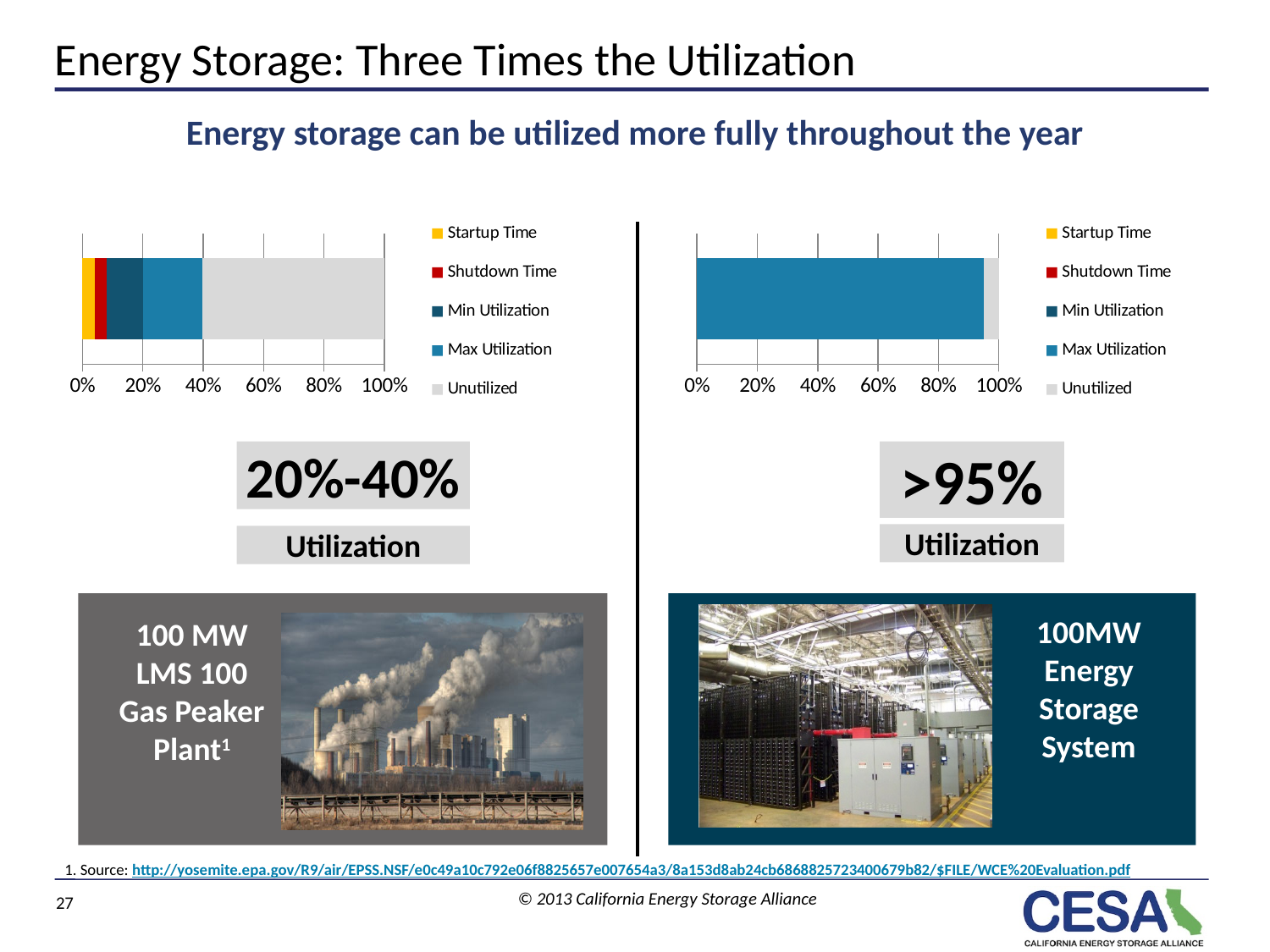
In the right chart, which series occupies the largest portion of the bar? Max Utilization In the left chart's legend, what colour represents Unutilized? Light grey How many series does the legend of the left chart list? 5 What is the highest value shown on the x axis of the right chart? 100% In the left chart, is the Unutilized segment greater or less than 40%? greater What kind of chart is the left chart on the slide? Stacked bar chart In the right chart, is the Unutilized segment greater or less than 20%? less In the left chart, which series occupies the largest portion of the bar? Unutilized How many series does the legend of the right chart list? 5 In the right chart, is the Max Utilization segment greater or less than 80%? greater In the left chart, which is larger: the Unutilized segment or the Max Utilization segment? Unutilized In the left chart, which is larger: the Max Utilization segment or the Startup Time segment? Max Utilization